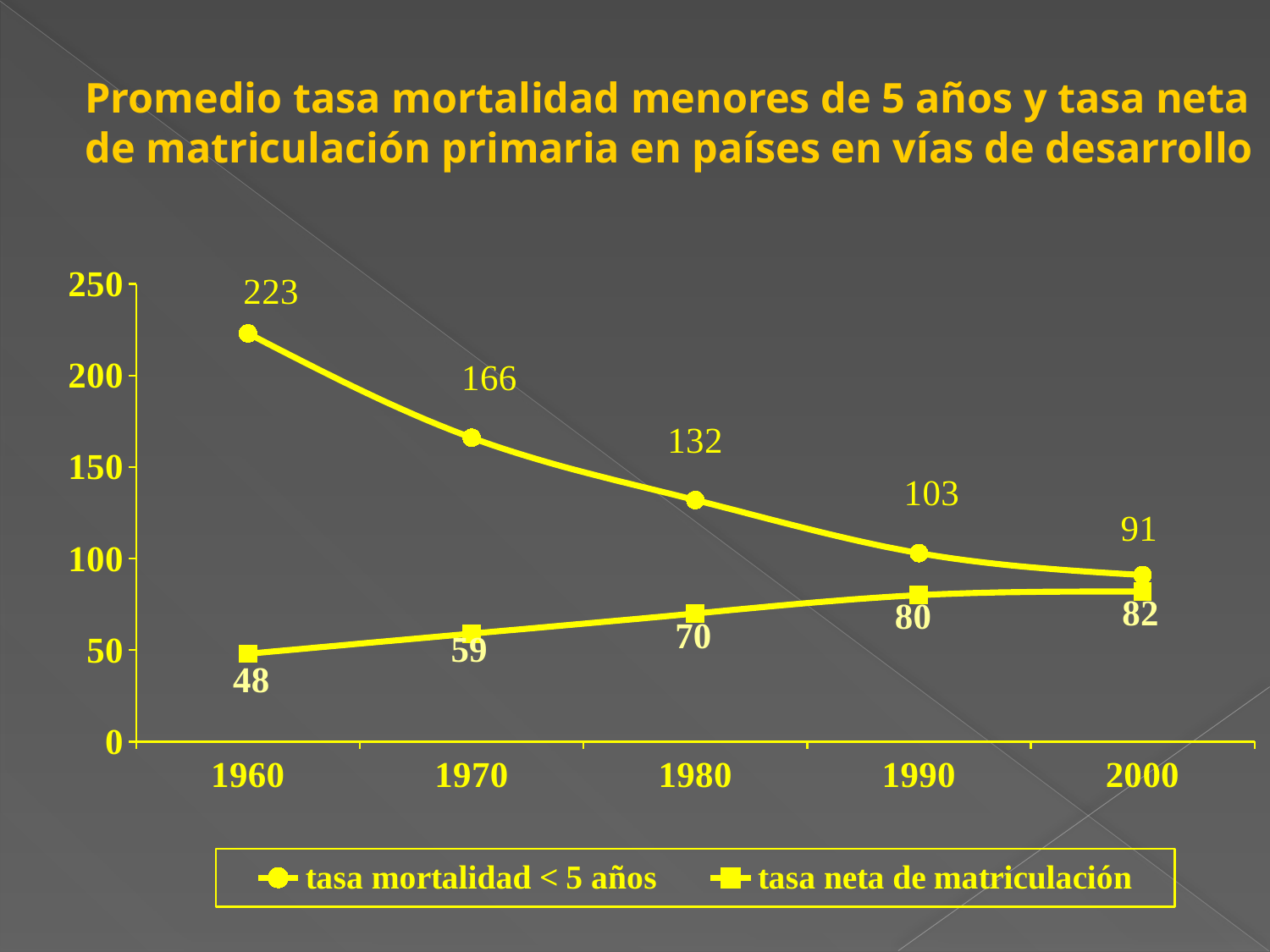
What is the value of 'tasa mortalidad < 5 años' in 2000? 91 In which year is 'tasa neta de matriculación' highest? 2000 In which year is 'tasa mortalidad < 5 años' lowest? 2000 Which is larger in 1990: 'tasa mortalidad < 5 años' or 'tasa neta de matriculación'? tasa mortalidad < 5 años What is the value of 'tasa mortalidad < 5 años' in 1960? 223 What marker shape is used for the 'tasa neta de matriculación' series? square What is the value of 'tasa neta de matriculación' in 1980? 70 How many series does the legend list? 2 What is the difference between 'tasa mortalidad < 5 años' in 1960 and in 1970? 57 How many years are plotted on the x axis? 5 Does 'tasa neta de matriculación' rise or fall from 1960 to 2000? rise What kind of chart is shown on the slide? line chart